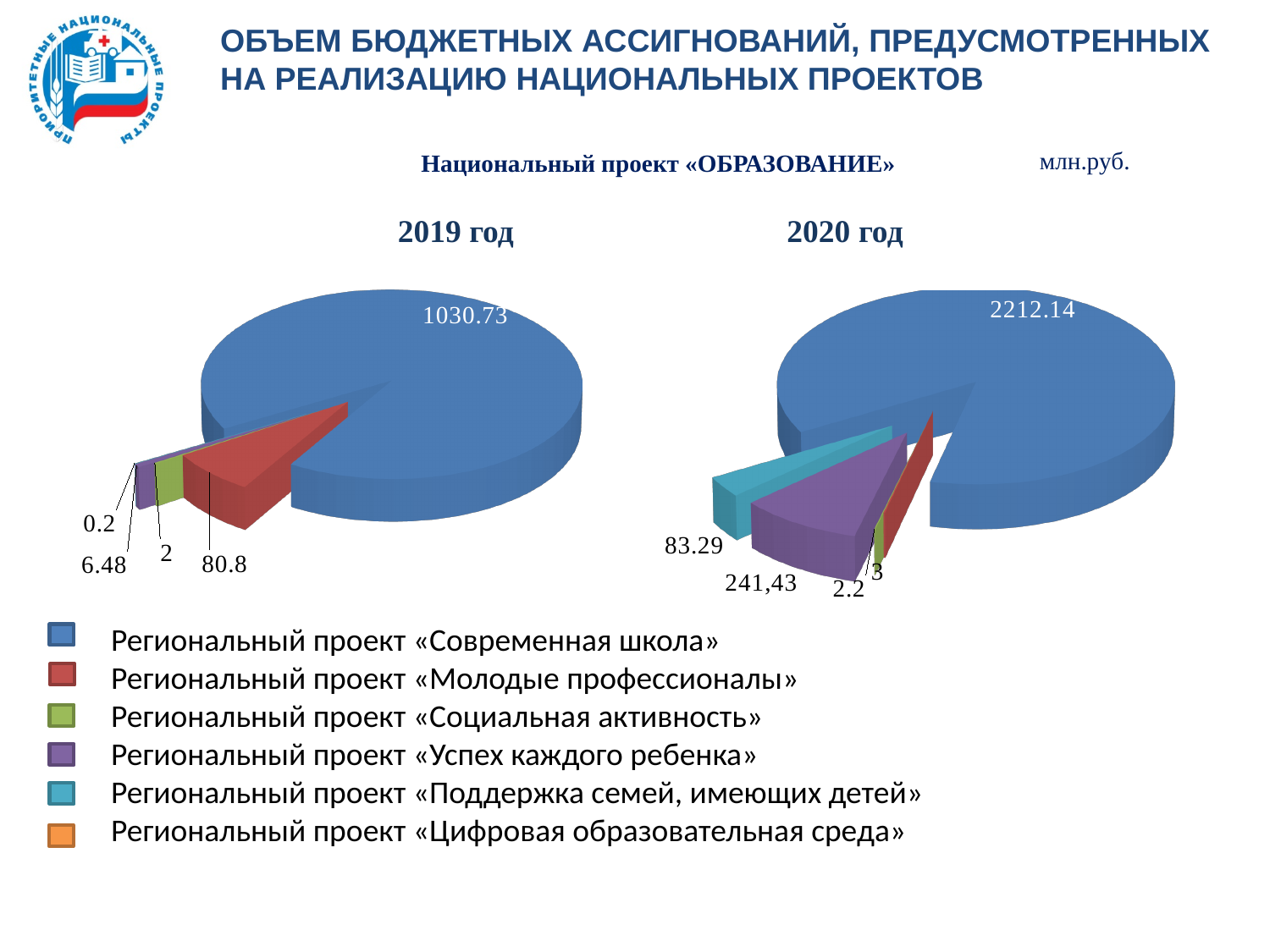
In the 2020 год chart, which regional project has the largest slice? Региональный проект «Современная школа» In the 2019 год chart, which regional project has the largest slice? Региональный проект «Современная школа» Which is larger: the value for «Современная школа» in the 2019 год chart or in the 2020 год chart? 2020 год In the 2019 год chart, what is the value for the regional project «Молодые профессионалы»? 80.8 In the 2019 год chart, what is the value for the regional project «Современная школа»? 1030.73 How many regional projects does the legend list? 6 What unit of measurement is indicated for the charts? млн.руб. In the 2020 год chart, what is the value for the regional project «Успех каждого ребенка»? 241,43 In the 2020 год chart, what is the value for the regional project «Современная школа»? 2212.14 What type of charts are shown on the slide? Pie charts